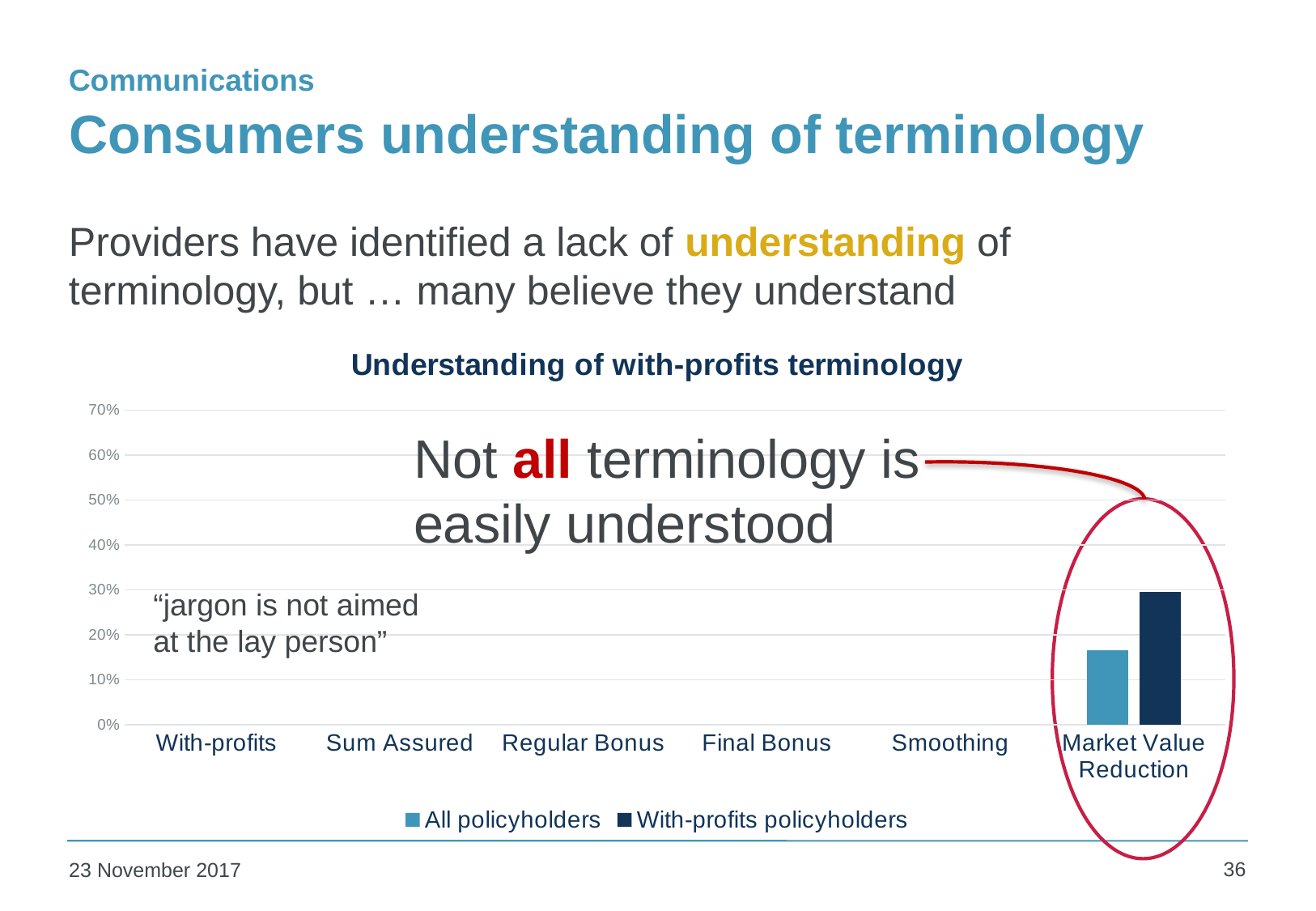
Is the With-profits policyholders value for Market Value Reduction greater or less than 20%? greater Is the All policyholders value for Market Value Reduction greater or less than 10%? greater What type of chart is shown on the slide? bar chart Is the All policyholders value for Market Value Reduction greater or less than 20%? less What is the highest value shown on the chart's y axis? 70% Which two series are listed in the chart legend? All policyholders and With-profits policyholders For Market Value Reduction, which series has the taller bar: All policyholders or With-profits policyholders? With-profits policyholders How many categories are labelled on the x axis of the chart? 6 What is the title of the chart? Understanding of with-profits terminology How many series does the chart legend list? 2